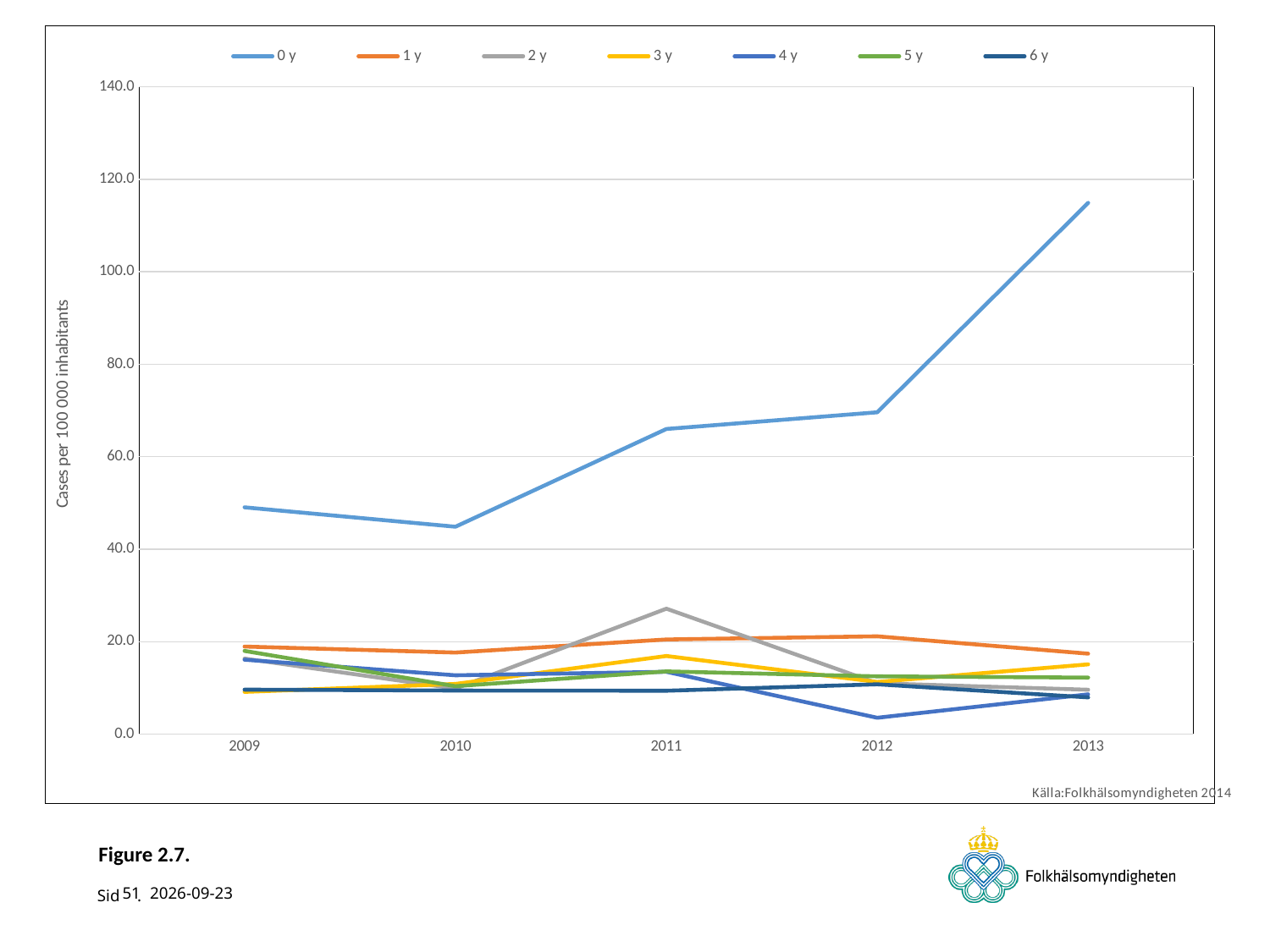
Does the 0 y series rise or fall from 2010 to 2013? rise Which series has the lowest value in 2012? 4 y How many years are shown along the x axis? 5 Which series has the highest value in 2013? 0 y Is the value for 2 y in 2011 greater or less than 20.0? greater Is the value for 0 y in 2010 greater or less than 60.0? less What is the label of the y axis? Cases per 100 000 inhabitants What kind of chart is shown on the slide? line chart How many series does the legend list? 7 Is the value for 0 y in 2013 greater or less than 100.0? greater What source is cited at the bottom right of the chart? Källa:Folkhälsomyndigheten 2014 Which is larger for the 0 y series: the value in 2012 or the value in 2013? 2013